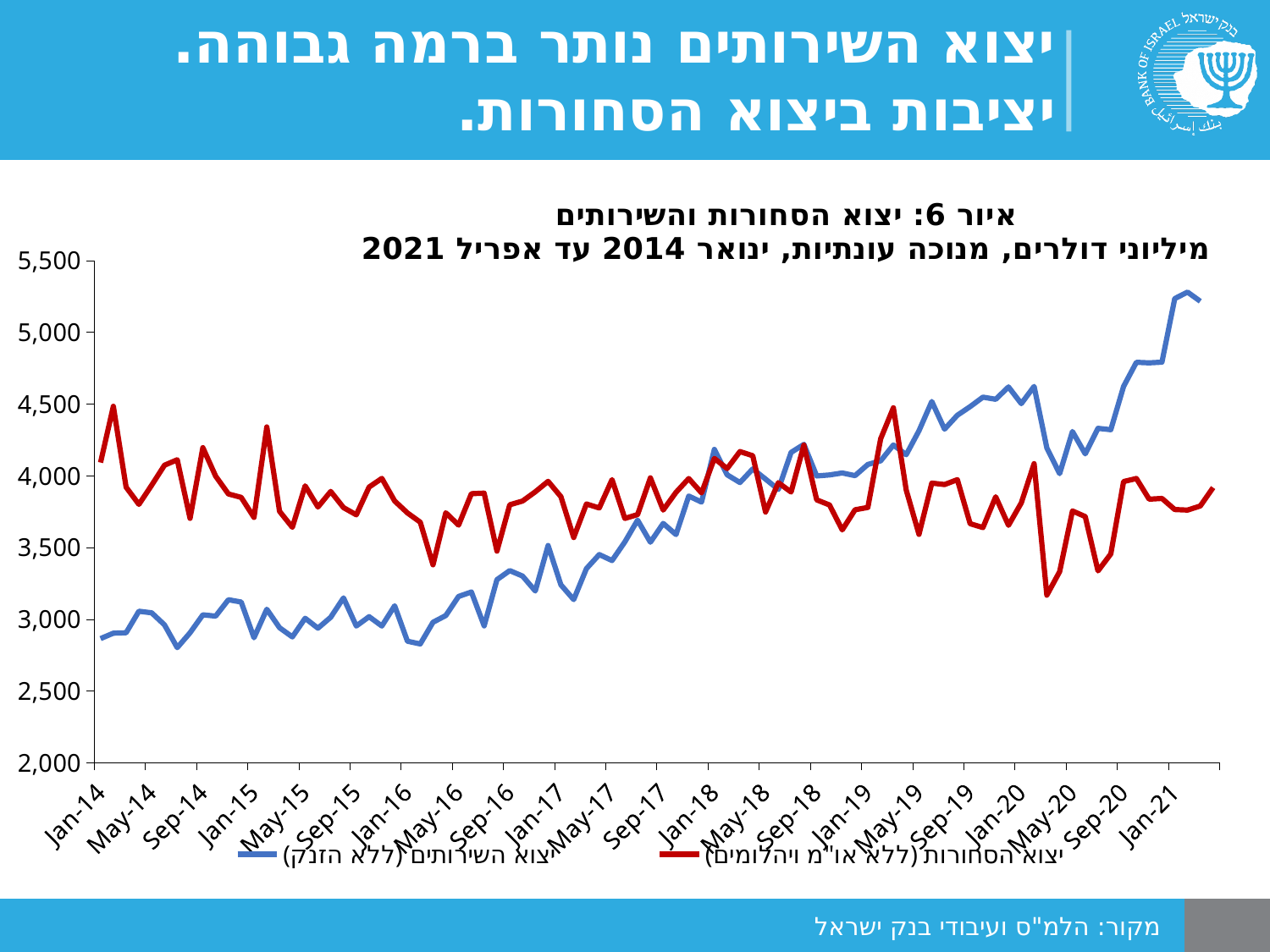
What kind of chart is shown on the slide? Line chart Is the value of the blue line (יצוא השירותים) at Jan-21 greater or less than 5,000? greater At Jan-21, which series has the higher value: יצוא השירותים (blue) or יצוא הסחורות (red)? יצוא השירותים (blue) Is the value of the red line (יצוא הסחורות) at May-20 greater or less than 3,500? greater At Jan-14, which series has the higher value: יצוא השירותים (blue) or יצוא הסחורות (red)? יצוא הסחורות (red) How many series does the legend list? 2 Does the blue line (יצוא השירותים) generally rise or fall from Jan-14 to Jan-21? Rise Is the value of the blue line (יצוא השירותים) at Jan-16 greater or less than 3,000? less Which series reaches the highest value on the chart? יצוא השירותים (ללא הזנק) What is the title of the chart? איור 6: יצוא הסחורות והשירותים